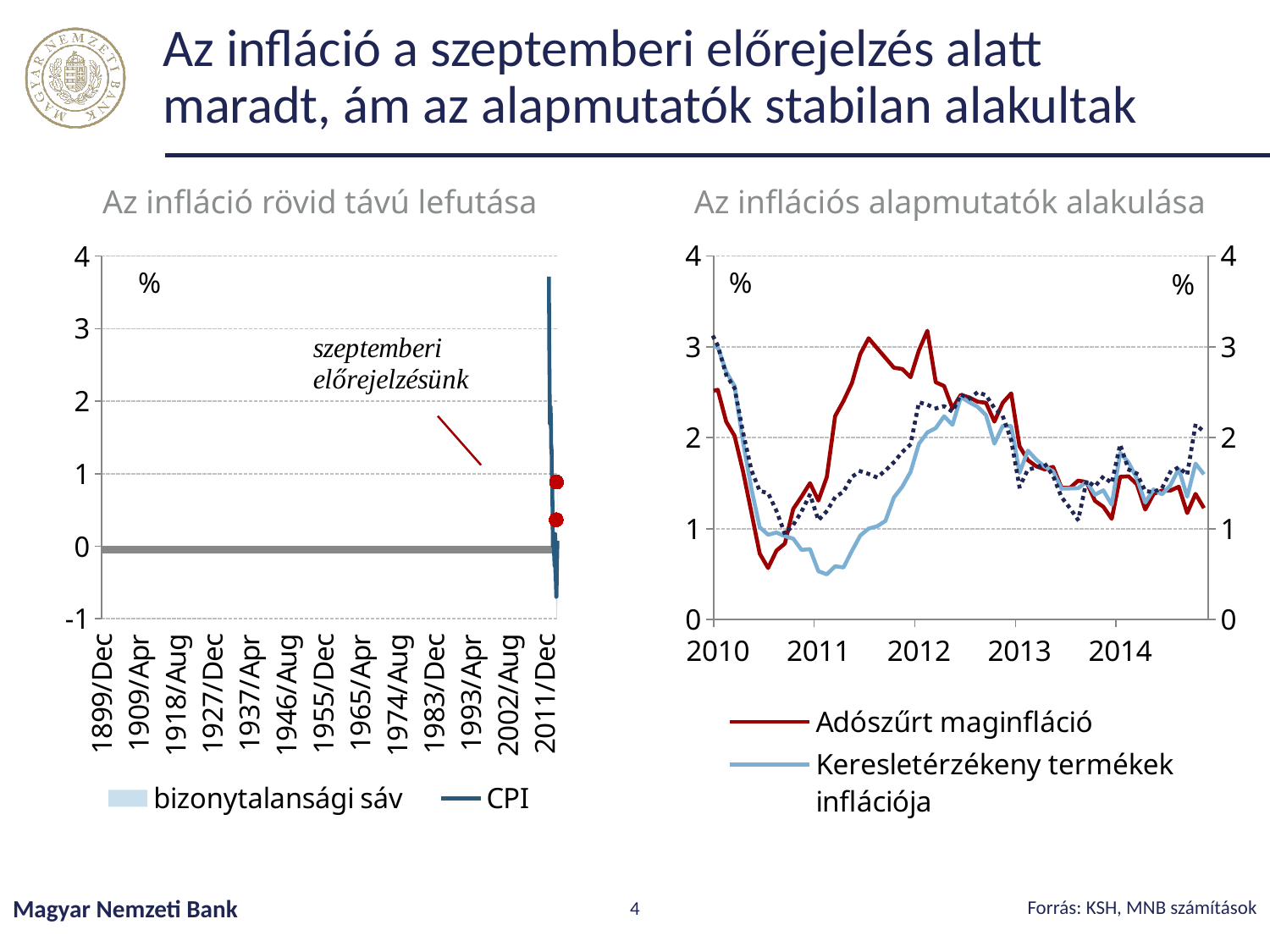
In the right-hand chart "Az inflációs alapmutatók alakulása", is the peak value of Adószűrt maginfláció in 2012 greater or less than 2? greater In the left-hand chart "Az infláció rövid távú lefutása", what are the two legend entries? bizonytalansági sáv, CPI In the right-hand chart "Az inflációs alapmutatók alakulása", does Adószűrt maginfláció generally rise or fall between the start of 2012 and the start of 2014? fall In the right-hand chart "Az inflációs alapmutatók alakulása", is the value of Keresletérzékeny termékek inflációja at the start of 2011 greater or less than 1? less How many series does the legend of the right-hand chart "Az inflációs alapmutatók alakulása" list? 2 In the right-hand chart "Az inflációs alapmutatók alakulása", which series is drawn in dark red? Adószűrt maginfláció In the right-hand chart "Az inflációs alapmutatók alakulása", at the start of 2012, which series is higher: Adószűrt maginfláció or Keresletérzékeny termékek inflációja? Adószűrt maginfláció In the right-hand chart "Az inflációs alapmutatók alakulása", does Keresletérzékeny termékek inflációja generally rise or fall between the start of 2011 and the start of 2012? rise What kind of chart is the right-hand chart titled "Az inflációs alapmutatók alakulása"? line chart In the right-hand chart "Az inflációs alapmutatók alakulása", is the value of Adószűrt maginfláció at the start of 2011 greater or less than 2? less What kind of chart is the left-hand chart titled "Az infláció rövid távú lefutása"? combination area and line chart How many entries does the legend of the left-hand chart "Az infláció rövid távú lefutása" list? 2